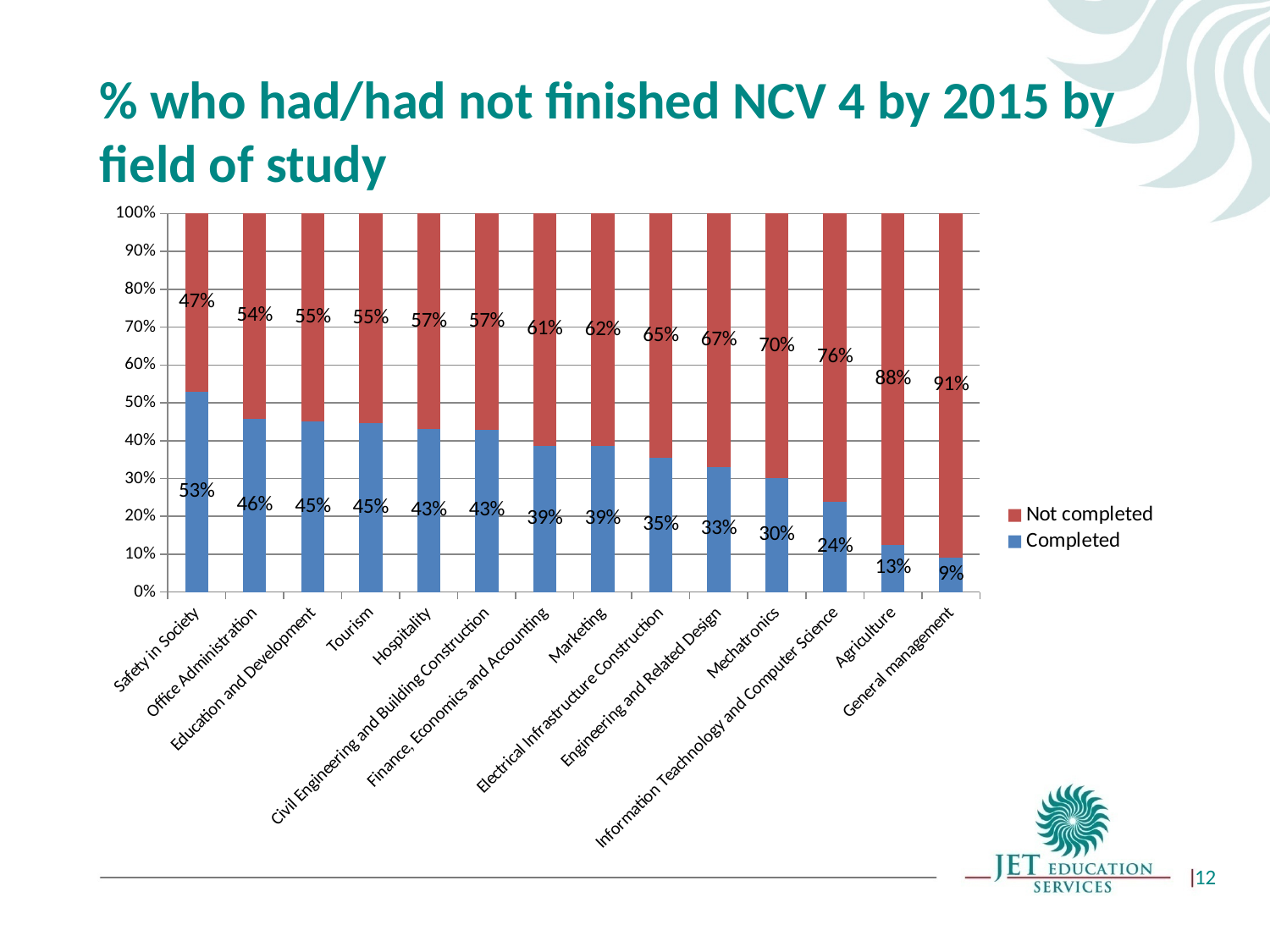
Which field of study has the lowest Completed percentage? General management What kind of chart is shown on the slide? Stacked bar chart Do the Completed values rise or fall moving from left to right along the x axis? Fall Which field of study has the highest Completed percentage? Safety in Society What is the difference between the Not completed values for Agriculture and Tourism? 33% Which colour represents the Not completed series? Red Which has a higher Completed percentage, Marketing or Agriculture? Marketing How many series does the legend list? 2 How many fields of study are shown on the x axis? 14 What percentage of Safety in Society students had completed NCV 4 by 2015? 53% What is the Completed value for Mechatronics? 30% What is the Not completed value for General management? 91%